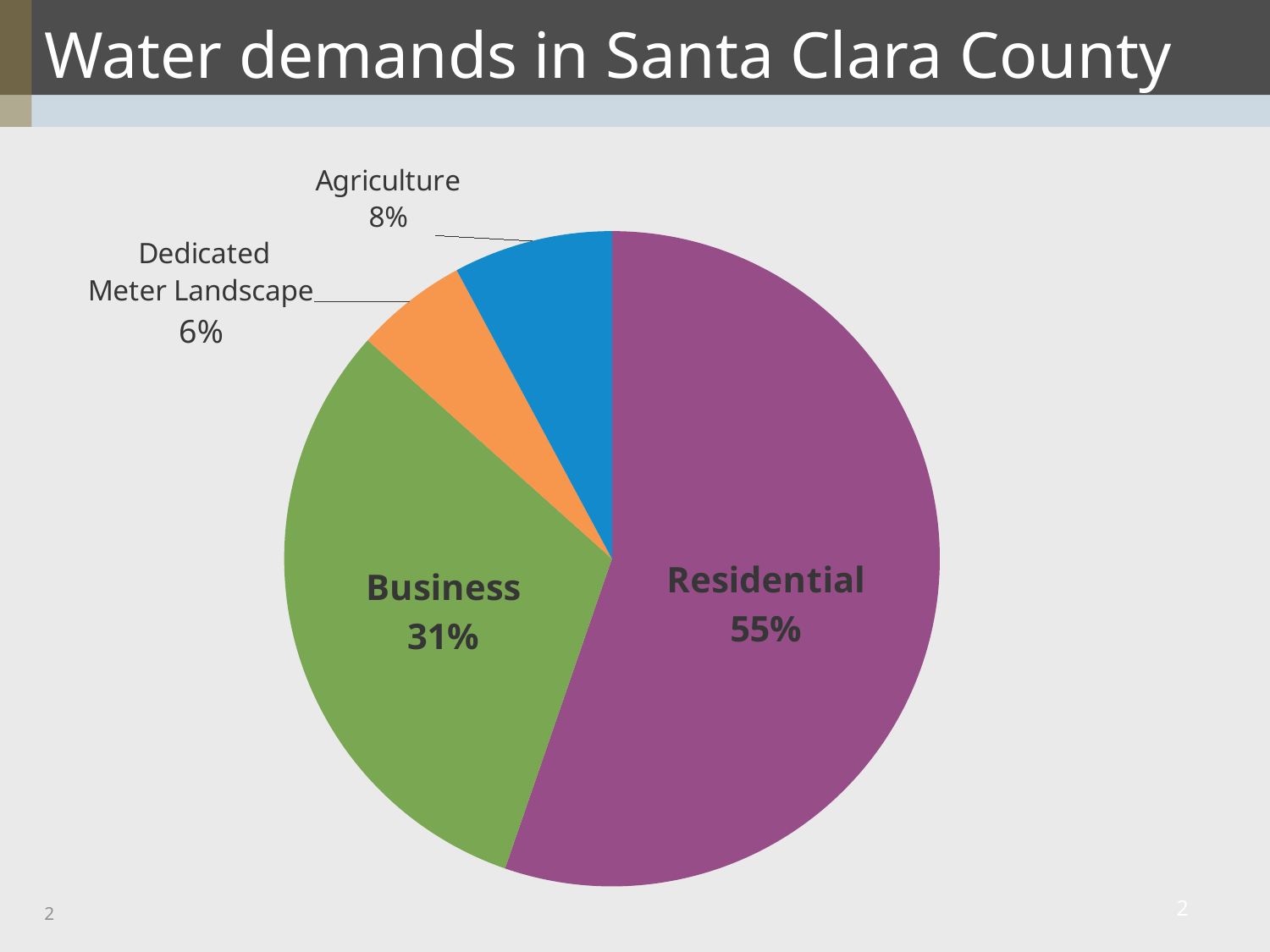
What share of water demand is Agriculture? 8% Which category has the largest share of water demand? Residential Which is larger, Agriculture or Dedicated Meter Landscape? Agriculture What share of water demand is Business? 31% How many categories are shown in the pie chart? 4 What kind of chart is shown on the slide? pie chart What share of water demand is Dedicated Meter Landscape? 6% What share of water demand is Residential? 55% What is the title of the chart? Water demands in Santa Clara County What is the difference in percentage points between Residential and Business? 24 Which category has the smallest share of water demand? Dedicated Meter Landscape What colour is the Residential slice? purple